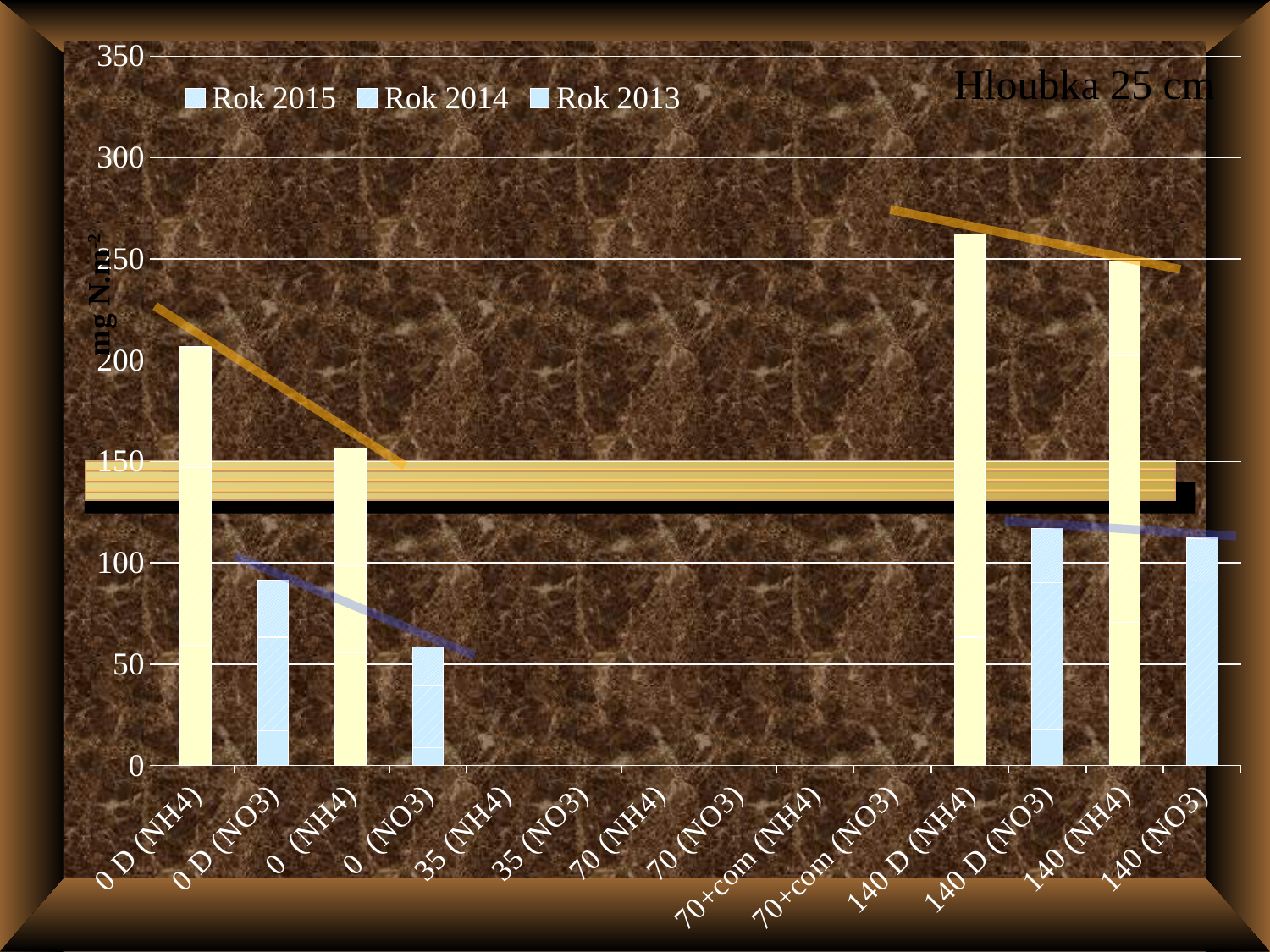
What is the title of the chart? Hloubka 25 cm Is the value for 0 D (NH4) greater or less than 150? greater Is the value for 140 (NO3) greater or less than 100? greater Is the value for 0 (NO3) greater or less than 100? less Which series are listed in the legend? Rok 2015, Rok 2014, Rok 2013 What kind of chart is shown on the slide? bar chart Which is larger, the value for 0 D (NH4) or the value for 0 (NH4)? 0 D (NH4) How many series does the legend list? 3 How many categories are shown on the x axis? 14 Which category has the lowest bar among those with visible bars? 0 (NO3)